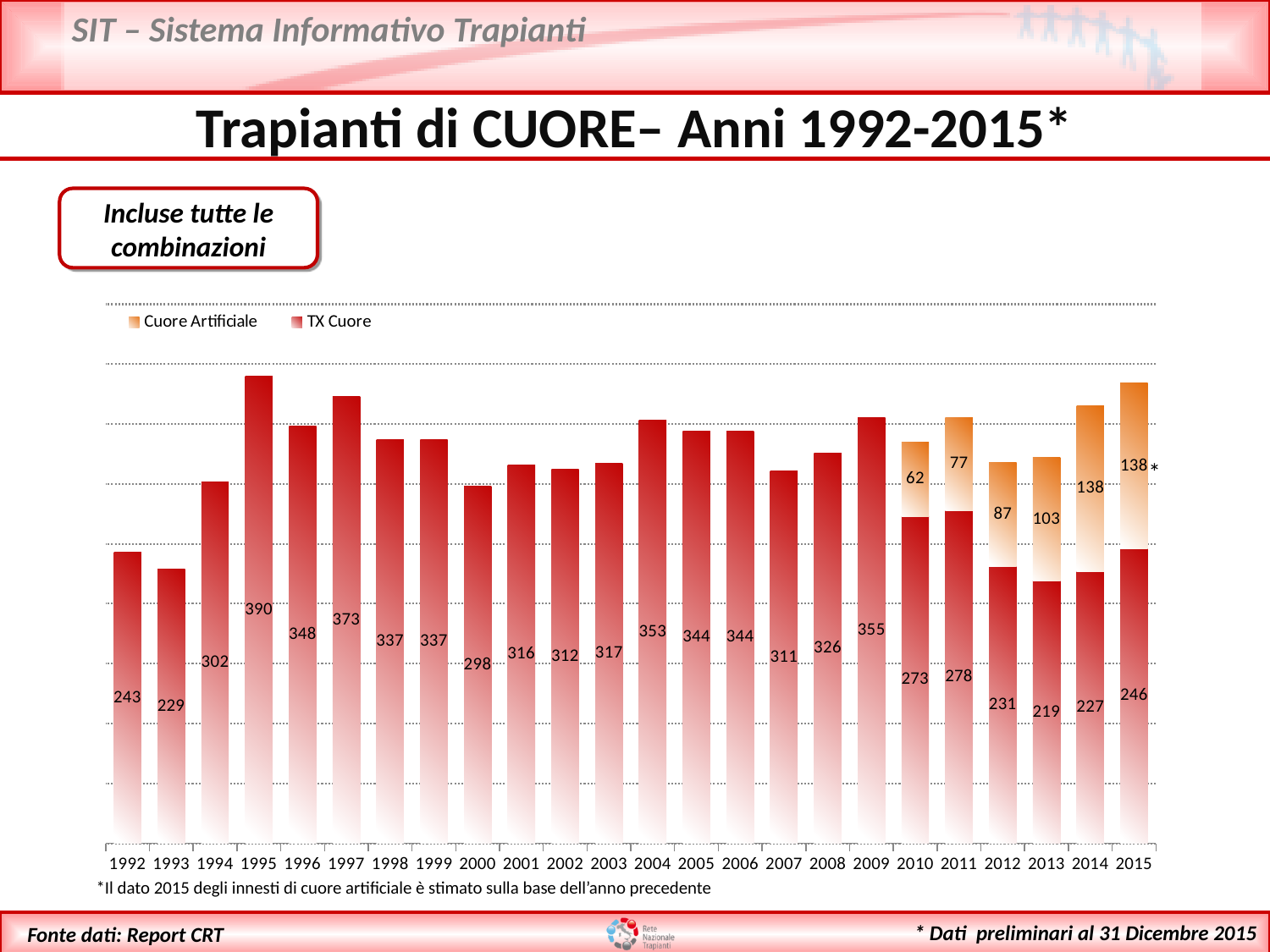
How many years are shown on the x axis? 24 What is the TX Cuore value for 1995? 390 Which is larger, the TX Cuore value for 2004 or for 2009? 2009 What kind of chart is shown on the slide? Stacked bar chart Which series is shown in orange in the legend? Cuore Artificiale What is the difference between the TX Cuore values for 1997 and 1996? 25 What is the total of the stacked bar for 2013 (TX Cuore plus Cuore Artificiale)? 322 Which year has the highest TX Cuore value? 1995 Which year has the lowest TX Cuore value? 2013 How many series does the legend list? 2 What is the TX Cuore value for 2000? 298 What is the Cuore Artificiale value for 2013? 103